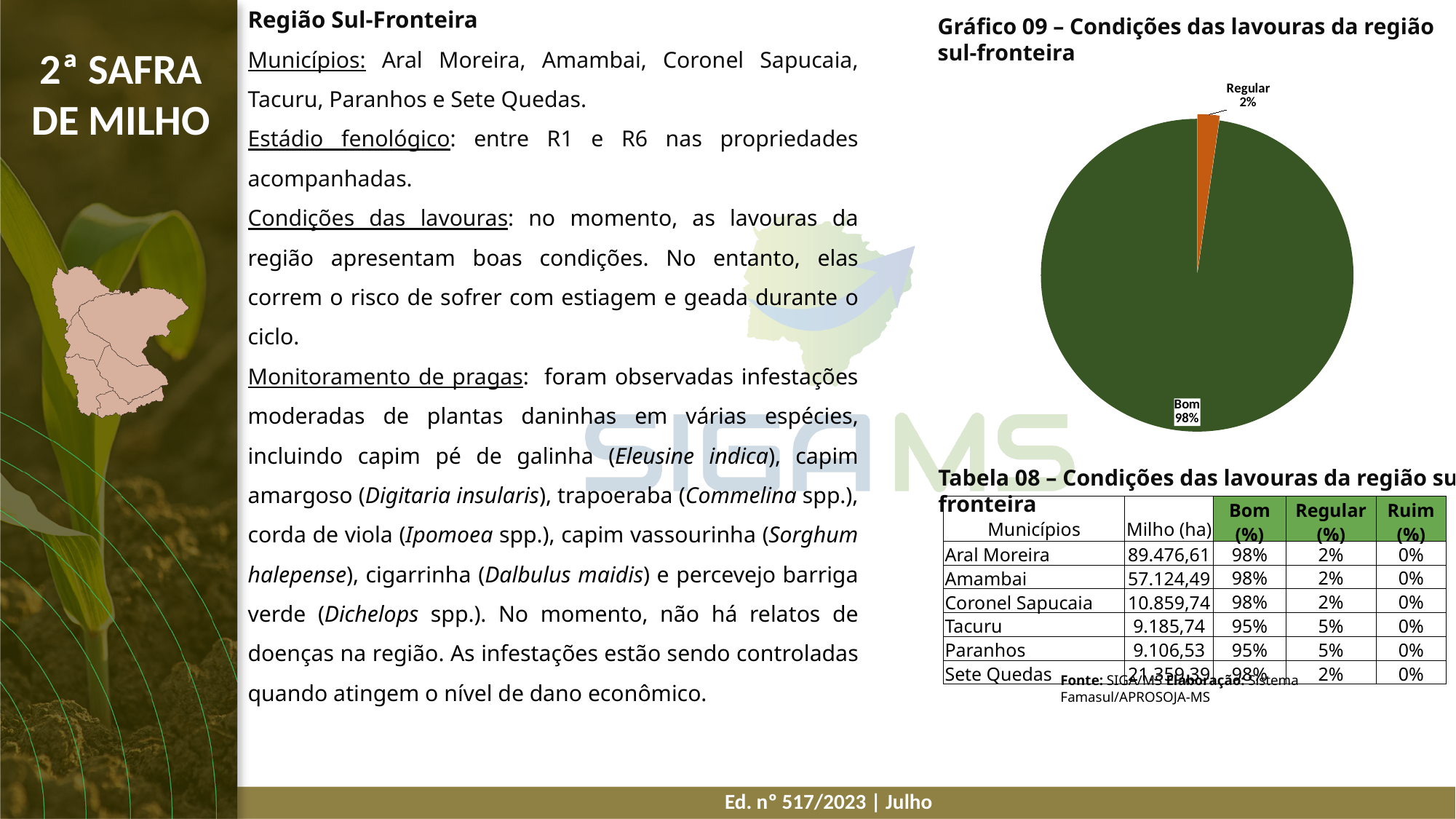
In Gráfico 09, what colour is the 'Bom' slice? dark green Which slice of Gráfico 09 is the smallest? Regular In Gráfico 09, what is the difference in percentage points between the 'Bom' and 'Regular' slices? 96 Which slice of Gráfico 09 is the largest? Bom In Gráfico 09, what share of the crops is in the 'Bom' condition? 98% How many slices does the pie chart in Gráfico 09 have? 2 What kind of chart is Gráfico 09? pie chart What is the title of the pie chart on the slide? Gráfico 09 – Condições das lavouras da região sul-fronteira In Gráfico 09, which is larger: the 'Bom' slice or the 'Regular' slice? Bom In Gráfico 09, what share of the crops is in the 'Regular' condition? 2%